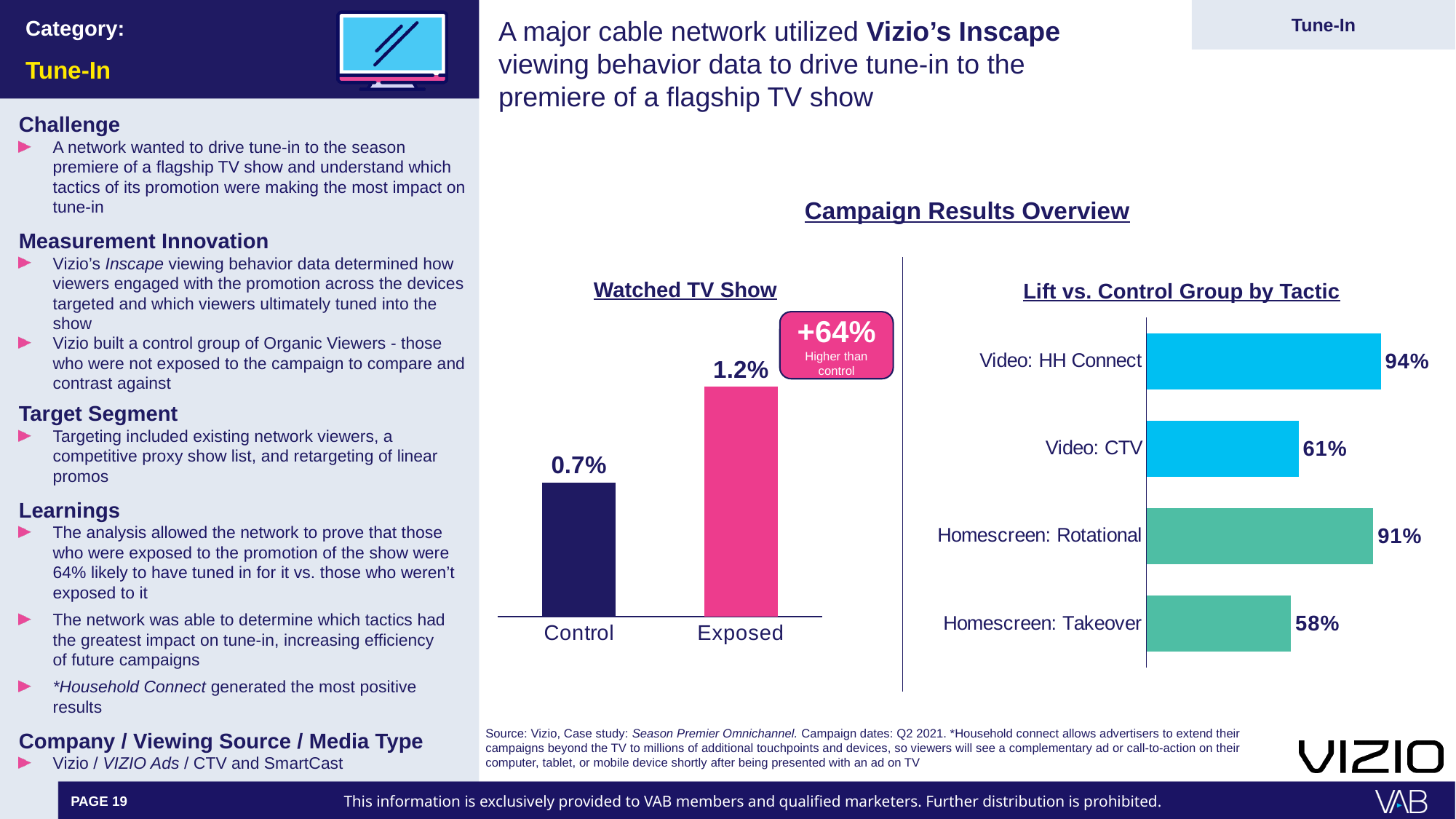
In the 'Watched TV Show' chart, what is the value for Exposed? 1.2% In the 'Lift vs. Control Group by Tactic' chart, which tactic has the highest lift? Video: HH Connect In the 'Watched TV Show' chart, what percentage higher than control is the Exposed group, according to the callout? +64% In the 'Lift vs. Control Group by Tactic' chart, what is the value for Homescreen: Takeover? 58% In the 'Lift vs. Control Group by Tactic' chart, what is the difference between Homescreen: Rotational and Video: CTV? 30% In the 'Watched TV Show' chart, what is the difference between the Exposed and Control values? 0.5% In the 'Lift vs. Control Group by Tactic' chart, what is the value for Video: HH Connect? 94% In the 'Watched TV Show' chart, how many bars are plotted? 2 In the 'Watched TV Show' chart, which bar is larger, Control or Exposed? Exposed What kind of chart is the 'Lift vs. Control Group by Tactic' chart? Bar chart In the 'Lift vs. Control Group by Tactic' chart, which tactic has the lowest lift? Homescreen: Takeover In the 'Watched TV Show' chart, what is the value for Control? 0.7%